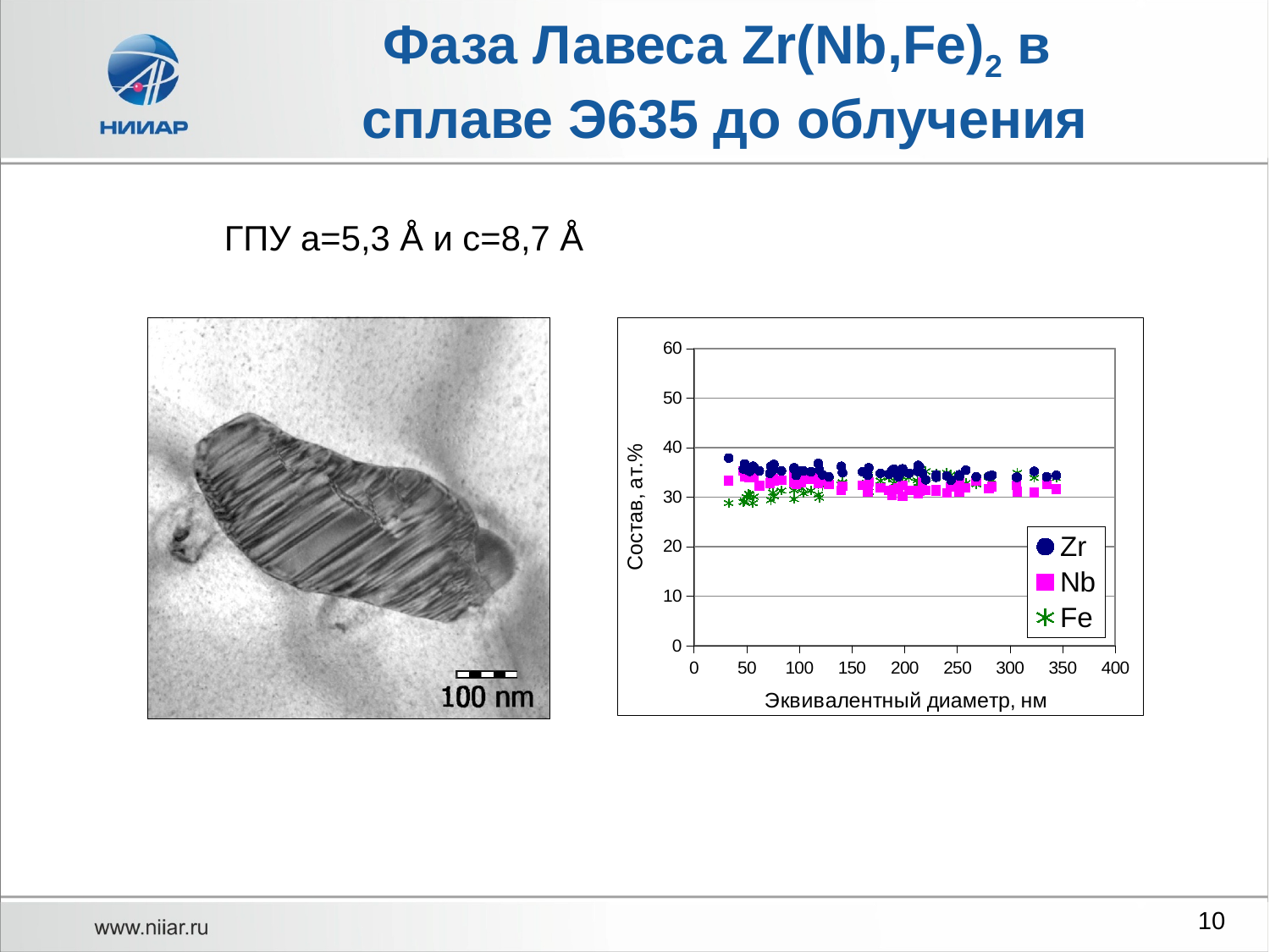
Do the Zr values rise, fall, or stay roughly flat as the equivalent diameter increases? roughly flat Which series has larger values, Zr or Fe? Zr Which series has the highest composition values across the plotted diameters? Zr Are the values for Nb greater or less than 40? less Are the values for Fe greater or less than 20? greater What kind of chart is shown on the slide? scatter chart Are the values for Zr greater or less than 40? less Which series has larger values, Zr or Nb? Zr What is the title of the x axis of the chart? Эквивалентный диаметр, нм What are the series names listed in the chart legend? Zr, Nb, Fe How many series does the legend of the chart list? 3